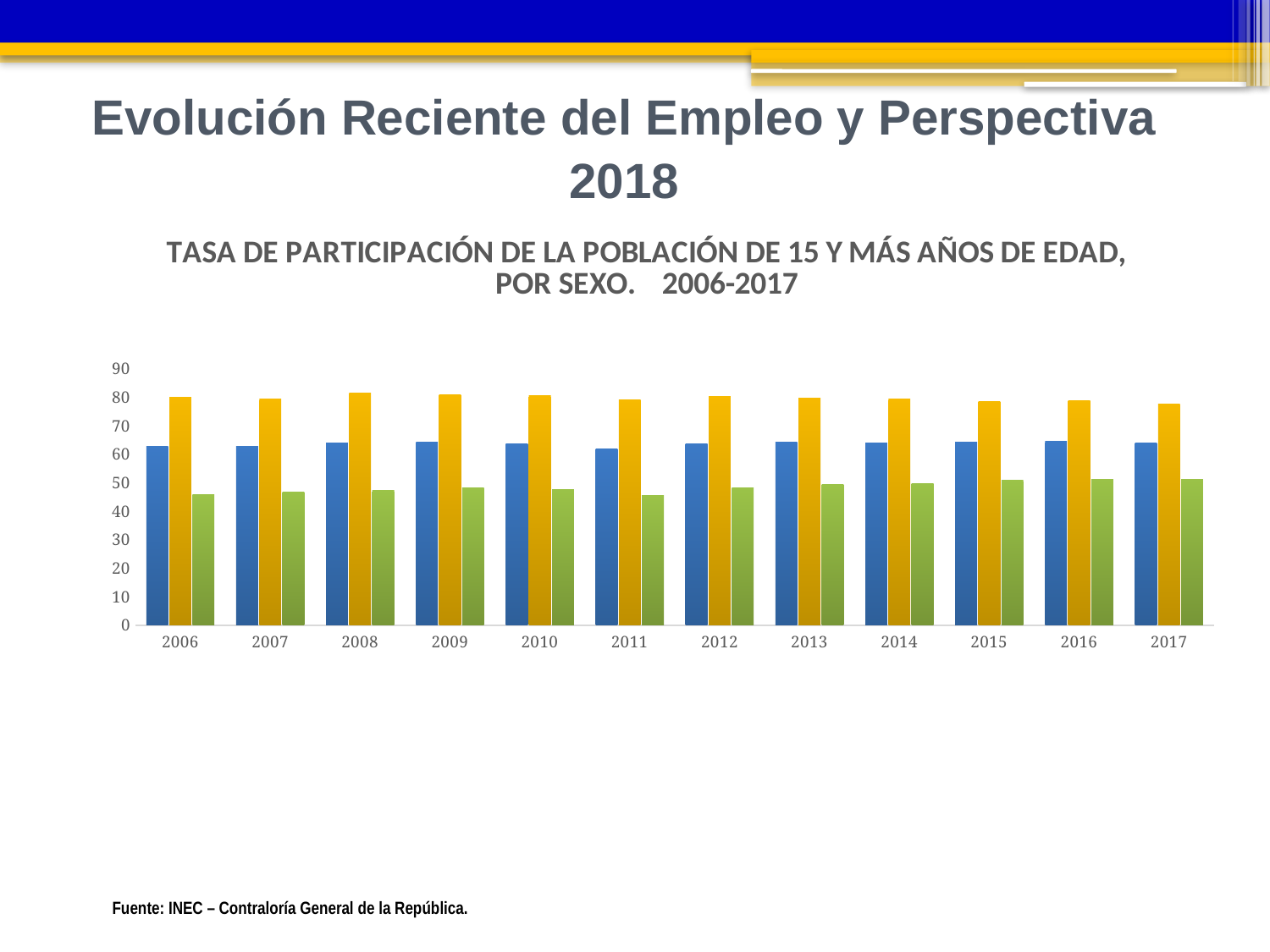
Is the value of the blue bar for 2009 greater or less than 50? greater What kind of chart is shown on the slide? bar chart How many years are shown along the x axis of the chart? 12 Do the green bars generally rise or fall from 2006 to 2017? rise Is the value of the green bar for 2011 greater or less than 50? less Is the value of the yellow bar for 2006 greater or less than 70? greater How many bars are plotted for each year in the chart? 3 In 2014, which bar is taller, the blue bar or the green bar? the blue bar What is the highest value shown on the y axis of the chart? 90 In 2010, which bar is taller, the yellow bar or the green bar? the yellow bar